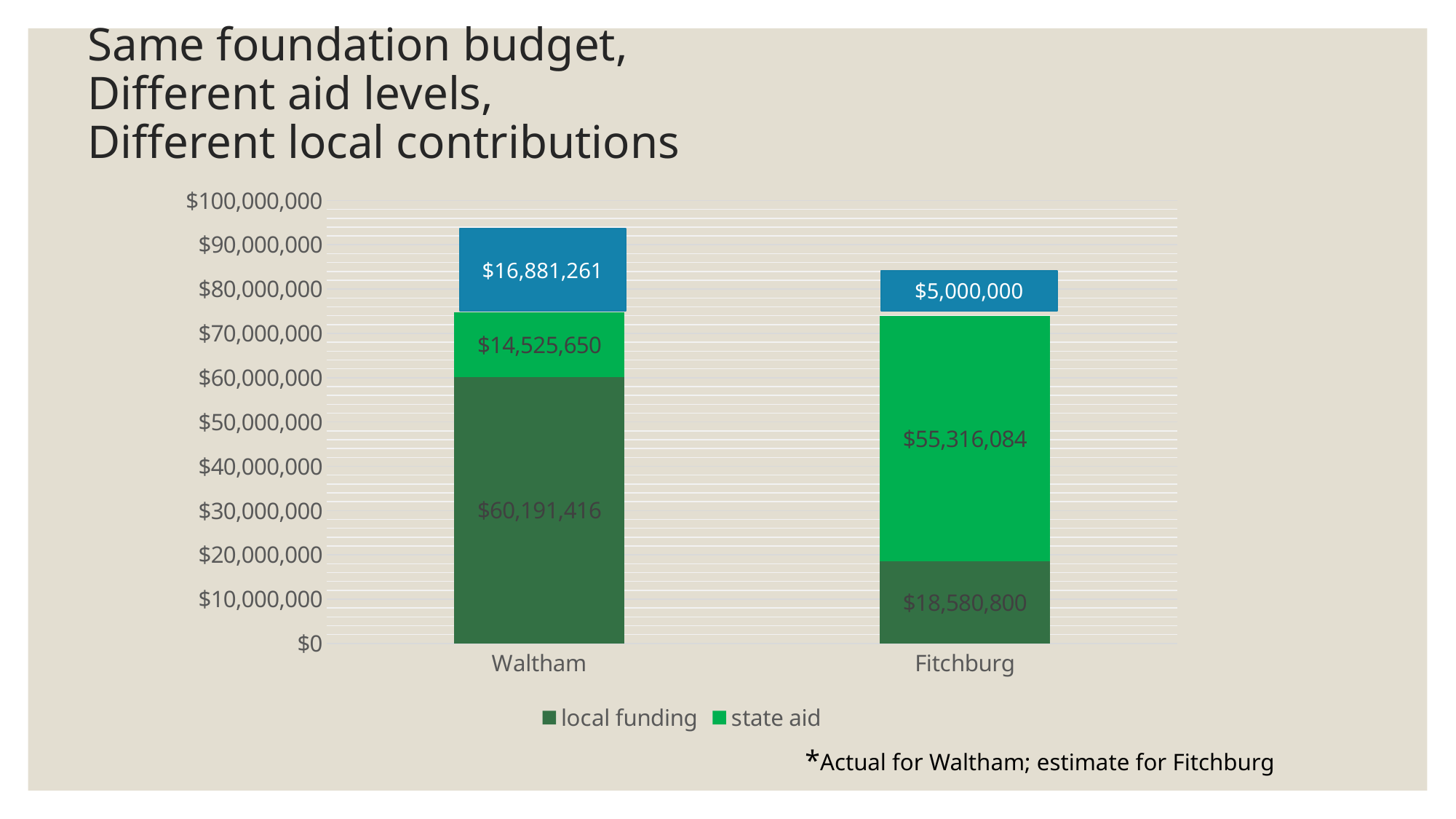
What is the state aid value for Fitchburg? $55,316,084 What is the difference in state aid between Fitchburg and Waltham? $40,790,434 Which district receives more state aid? Fitchburg What type of chart is shown on the slide? Stacked bar chart What is the state aid value for Waltham? $14,525,650 How many districts are shown on the x axis? 2 What is the local funding value for Waltham? $60,191,416 How many series does the legend list? 2 What value is shown in the blue segment at the top of the Fitchburg bar? $5,000,000 What is the difference in local funding between Waltham and Fitchburg? $41,610,616 What is the combined total of local funding and state aid for Waltham? $74,717,066 Which district has the higher local funding, Waltham or Fitchburg? Waltham